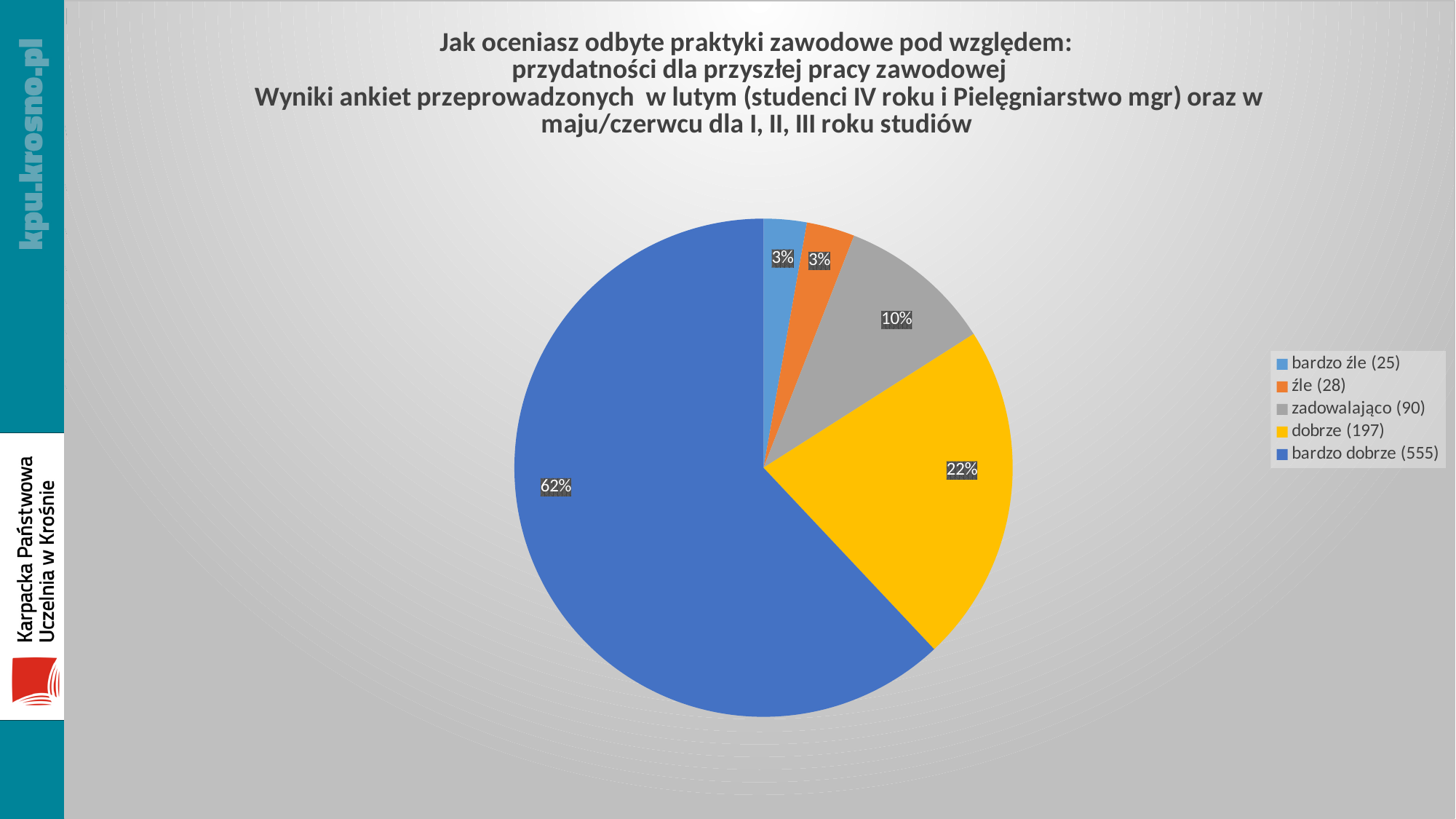
What kind of chart is shown on the slide? pie chart What percentage of the pie does the "dobrze" slice represent? 22% What percentage of the pie does the "zadowalająco" slice represent? 10% What is the difference in the number of responses between "źle" (28) and "bardzo źle" (25)? 3 How many responses does the legend show for "dobrze"? 197 What colour is the "dobrze" slice in the pie chart? yellow Which has more responses, "dobrze" or "zadowalająco"? dobrze What is the difference in the number of responses between "bardzo dobrze" (555) and "dobrze" (197)? 358 Which category has the largest slice of the pie? bardzo dobrze What percentage of the pie does the "bardzo dobrze" slice represent? 62% How many slices does the pie chart have? 5 How many responses does the legend show for "zadowalająco"? 90